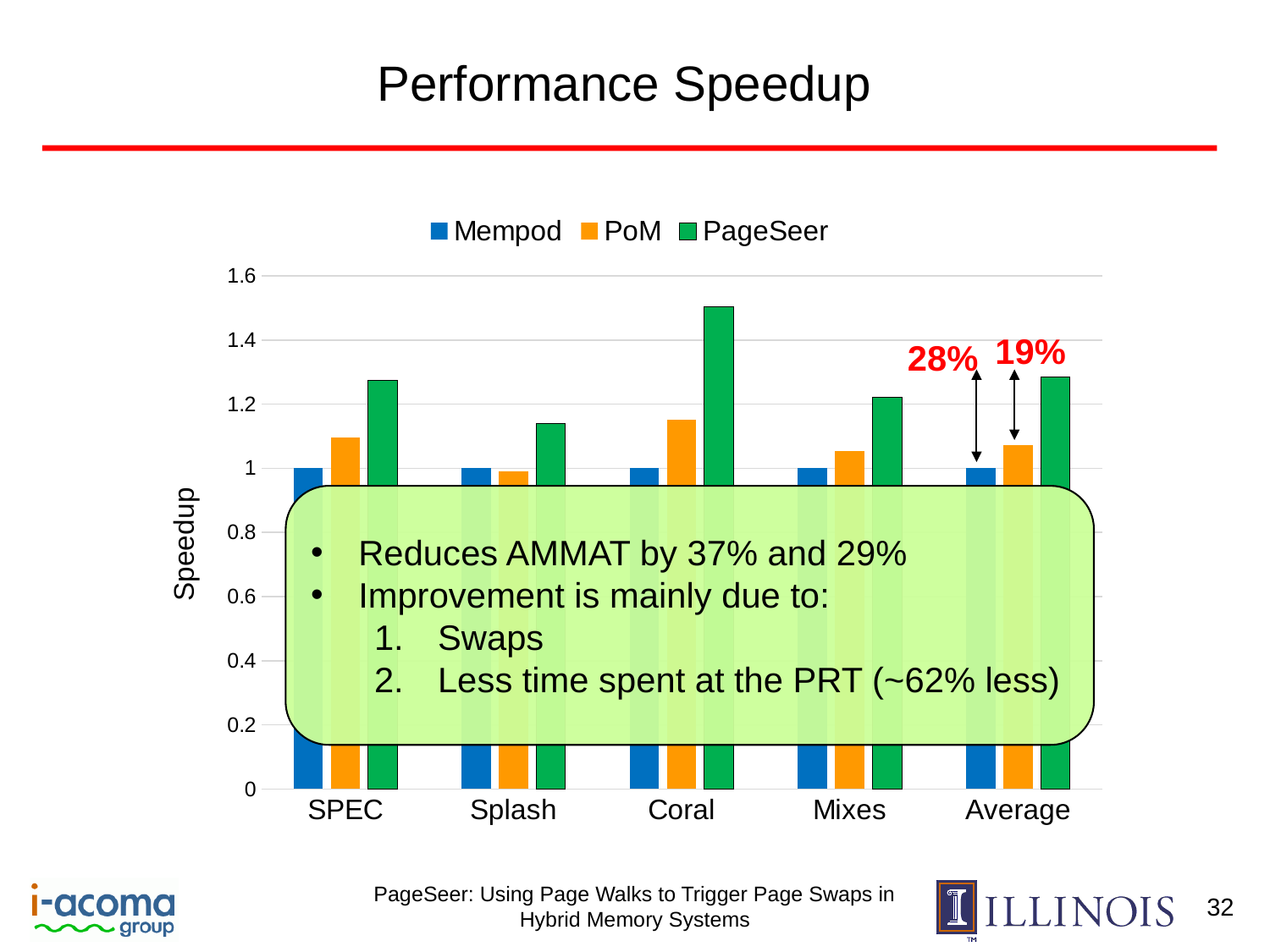
For Coral, which is larger: the PoM value or the PageSeer value? PageSeer Which category has the lowest PageSeer speedup? Splash What kind of chart is shown on the slide? bar chart Is the PageSeer value for SPEC greater or less than 1.2? greater Is the PageSeer value for Coral greater or less than 1.4? greater What is the label on the y axis? Speedup Which category has the highest PageSeer speedup? Coral What is the Mempod speedup value for Average? 1 How many series does the legend list? 3 What percentage annotation is shown in red above the PageSeer bar for Average? 19% How many categories are shown on the x axis? 5 Is the PoM value for Coral greater or less than 1? greater